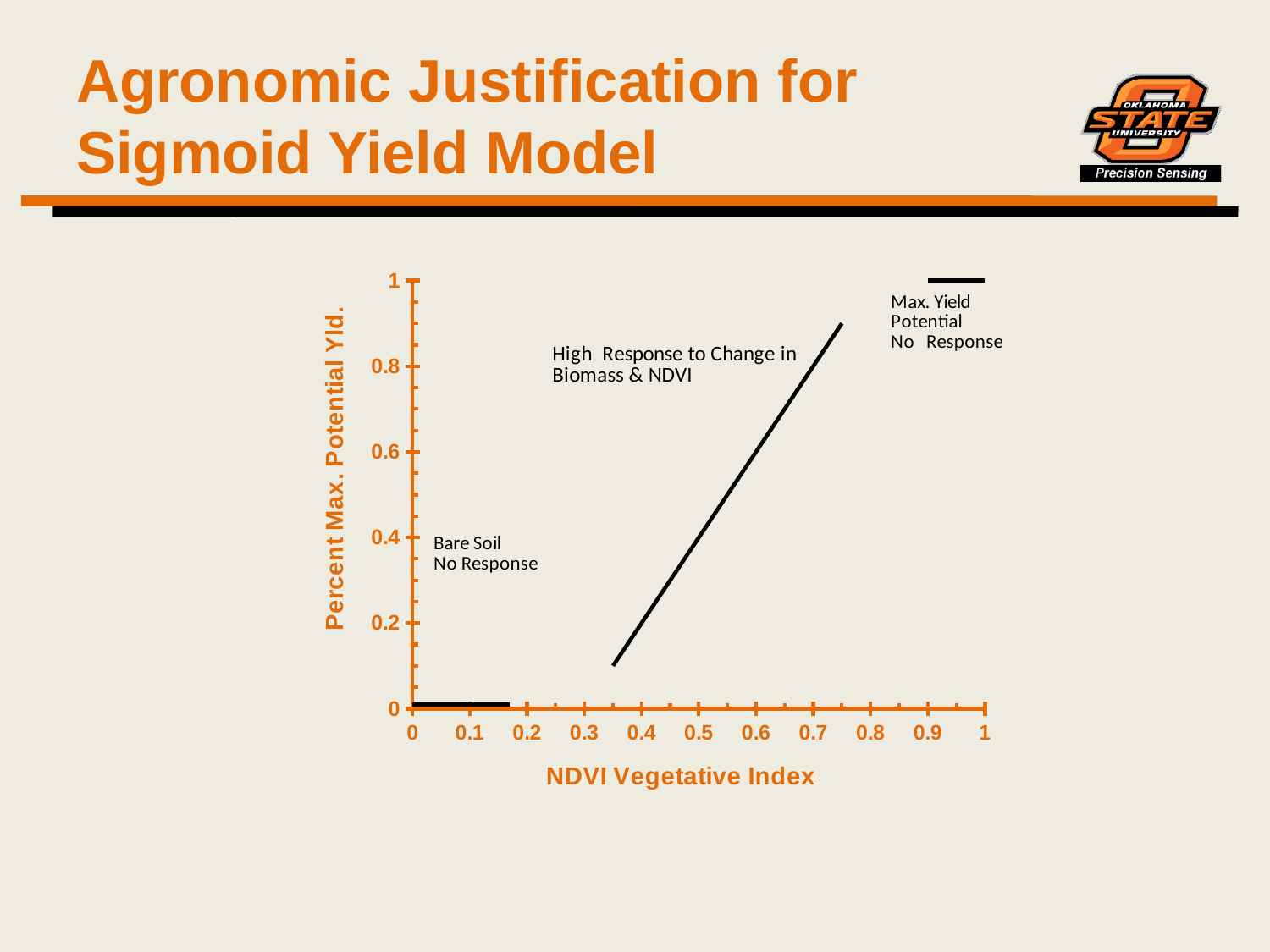
What is the title of the x axis of the chart? NDVI Vegetative Index What is the highest tick value shown on the x axis? 1 Is the value for NDVI 0.5 greater or less than 0.2? greater Is the value for NDVI 0.95 greater or less than 0.8? greater Is the value for NDVI 0.7 greater or less than 0.6? greater What kind of chart is shown on the slide? Line chart Does the plotted line rise or fall as NDVI increases from 0.4 to 0.7? Rise Which of the two flat segments is higher: the one near NDVI 0.1 or the one near NDVI 0.95? The one near NDVI 0.95 What is the title of the y axis of the chart? Percent Max. Potential Yld. How many separate line segments are plotted on the chart? 3